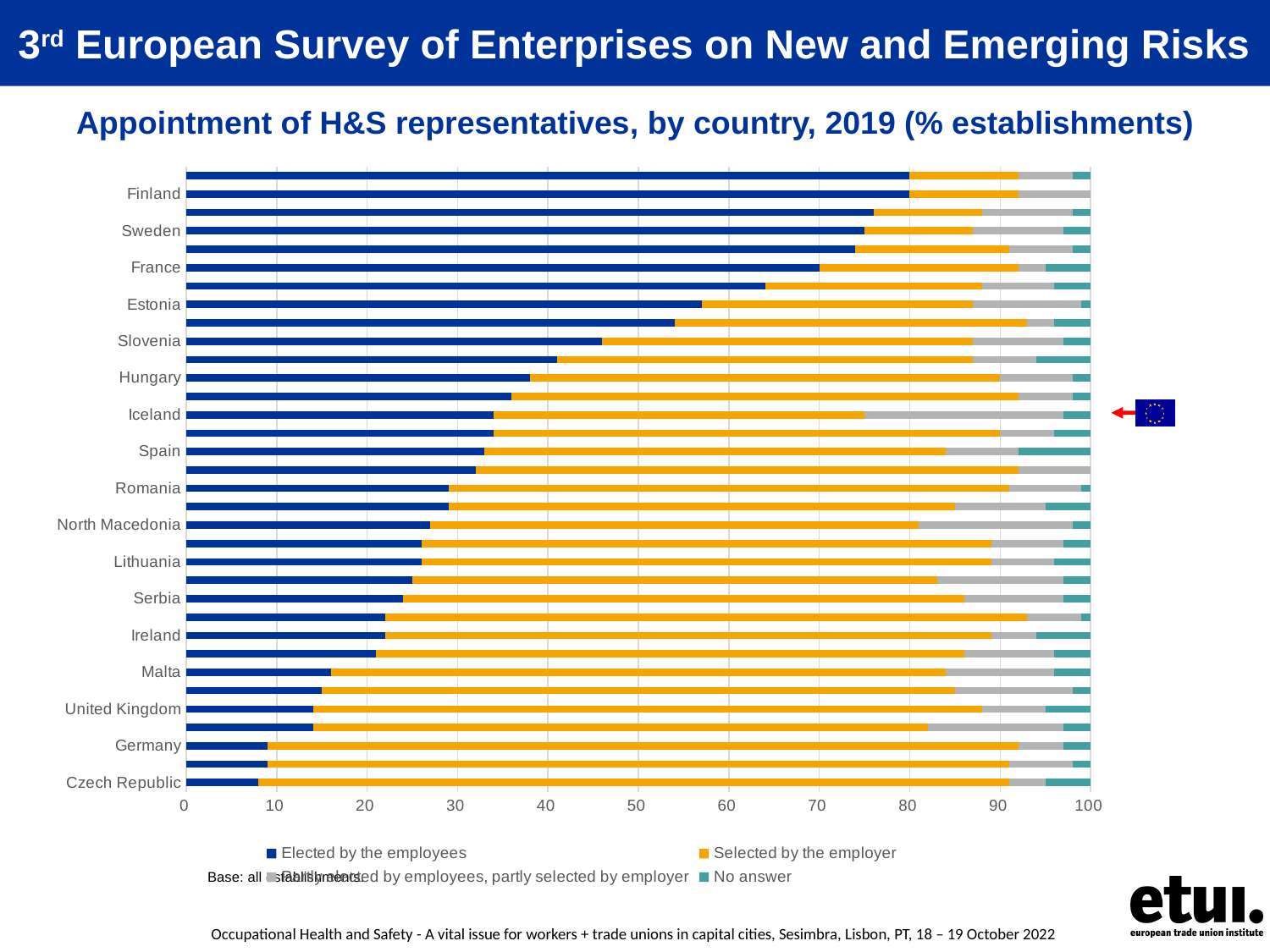
What kind of chart is shown on the slide? bar chart What is the title of the chart? Appointment of H&S representatives, by country, 2019 (% establishments) Is the 'Elected by the employees' value for Finland greater or less than 70? greater Which labelled country has the lowest share of establishments with H&S representatives elected by the employees? Czech Republic Which has a larger 'Elected by the employees' share, Sweden or Germany? Sweden Is the 'Elected by the employees' value for Spain greater or less than 40? less How many series does the legend list? 4 Going from the top of the chart (Finland) to the bottom (Czech Republic), does the 'Elected by the employees' share rise or fall? fall Is the 'Elected by the employees' value for Estonia greater or less than 50? greater Which labelled country has the highest share of establishments with H&S representatives elected by the employees? Finland